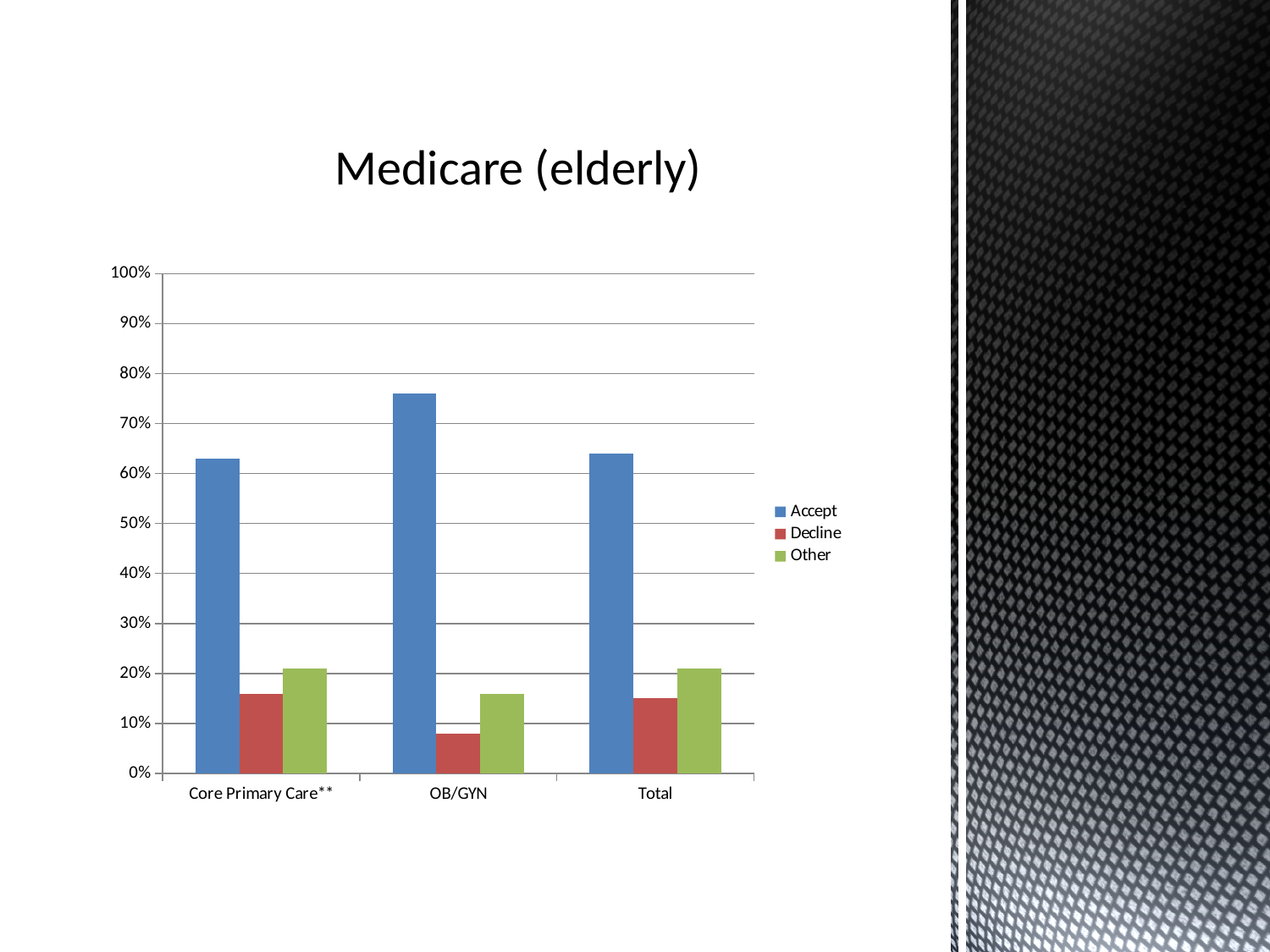
Is the Decline value for OB/GYN greater or less than 10%? less How many categories are shown on the x axis? 3 What type of chart is shown on the slide? bar chart Which category has the lowest Other value? OB/GYN For OB/GYN, which is larger: the Decline value or the Other value? Other What is the title of the chart? Medicare (elderly) Is the Accept value for Total greater or less than 70%? less Which category has the lowest Decline value? OB/GYN How many series does the legend list? 3 Which series is shown in blue in the legend? Accept Is the Accept value for OB/GYN greater or less than 70%? greater Which category has the highest Accept value? OB/GYN